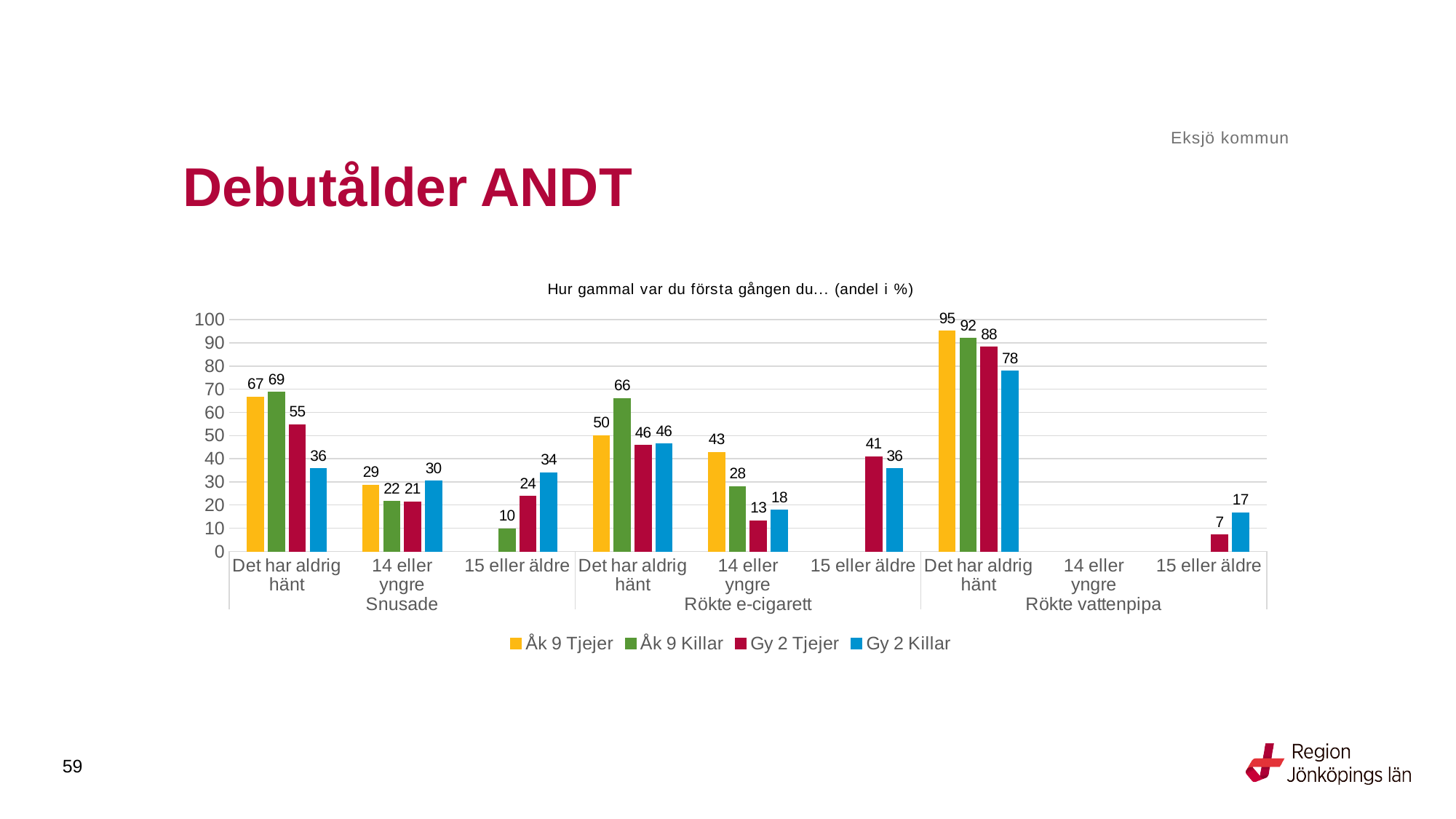
What type of chart is shown on the slide? bar chart What is the difference between Åk 9 Tjejer and Gy 2 Killar for 'Det har aldrig hänt' under Snusade? 31 Is the value for Gy 2 Killar for 'Det har aldrig hänt' under Rökte vattenpipa greater or less than 70? greater What is the difference between Åk 9 Tjejer and Åk 9 Killar for '14 eller yngre' under Rökte e-cigarett? 15 How many series does the legend list? 4 Which series has the lowest value for '14 eller yngre' under Rökte e-cigarett? Gy 2 Tjejer What is the value for Gy 2 Tjejer for 'Det har aldrig hänt' under Snusade? 55 What is the value for Gy 2 Killar for '15 eller äldre' under Rökte vattenpipa? 17 Which series has the highest value for 'Det har aldrig hänt' under Rökte vattenpipa? Åk 9 Tjejer What is the value for Åk 9 Killar for 'Det har aldrig hänt' under Rökte e-cigarett? 66 What is the title of the chart? Hur gammal var du första gången du… (andel i %) Which is larger for '15 eller äldre' under Snusade: Gy 2 Tjejer or Gy 2 Killar? Gy 2 Killar